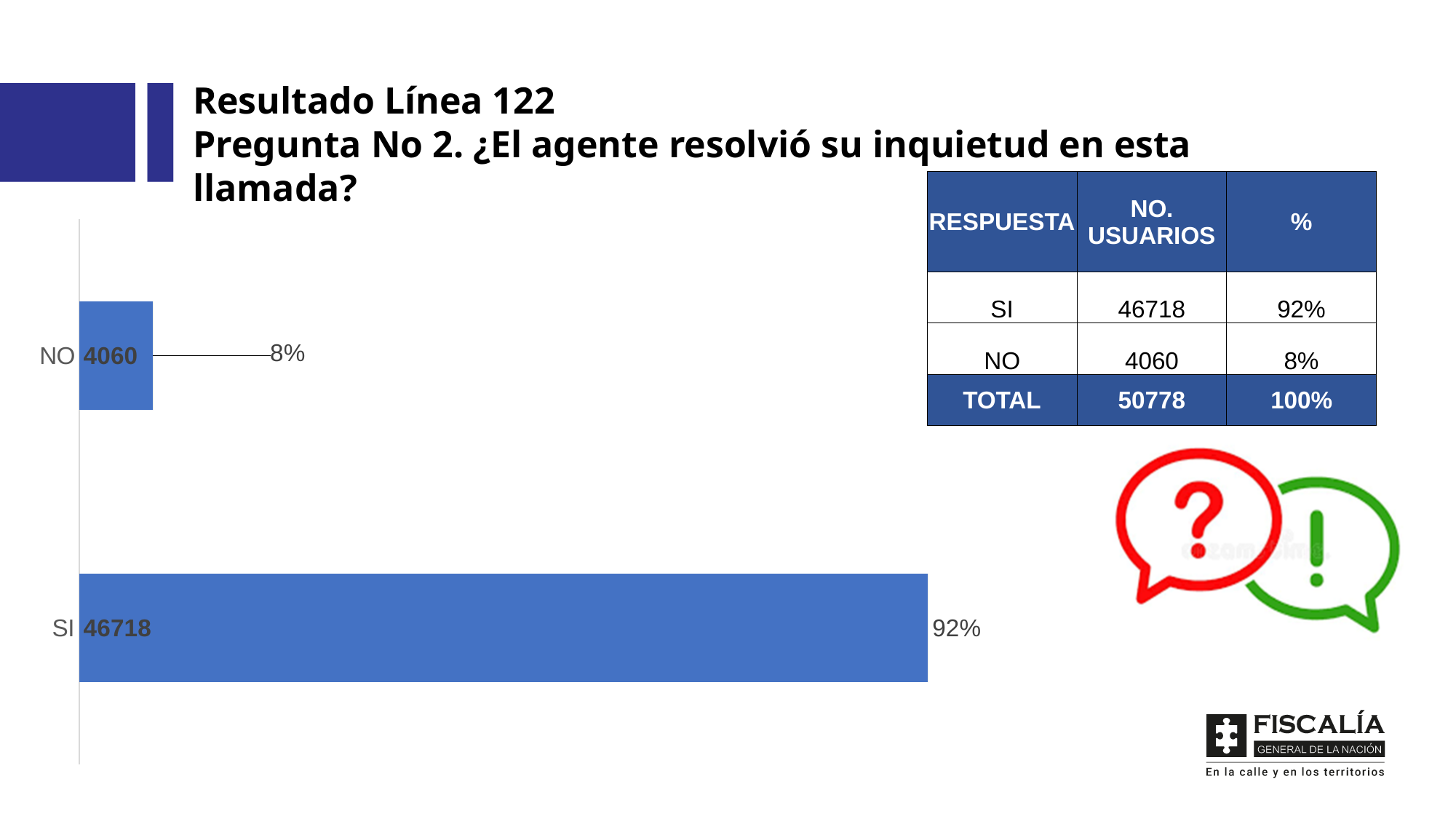
What is the value for NO in the bar chart? 4060 What is the total number of users shown in the table? 50778 What is the value for SI in the bar chart? 46718 What is the difference between the SI and NO values in the bar chart? 42658 What kind of chart is shown on the slide? Bar chart How many categories are shown in the bar chart? 2 Which category has the lowest value in the bar chart? NO What percentage is shown next to the SI bar? 92% What percentage is shown next to the NO bar? 8% What colour are the bars in the chart? Blue Which is larger, the value for SI or the value for NO? SI Which category has the highest value in the bar chart? SI